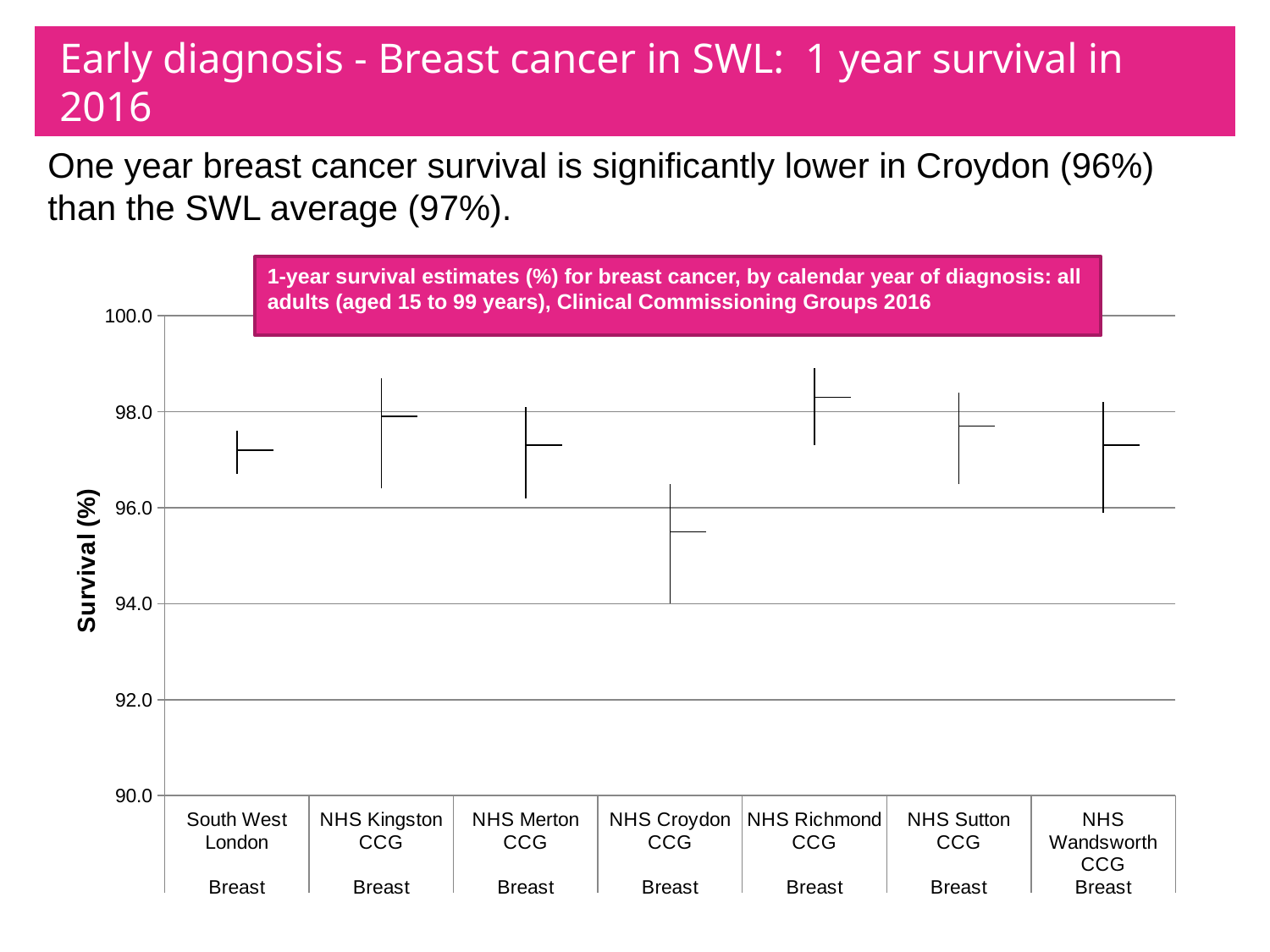
Which CCG has the lowest 1-year breast cancer survival estimate on the chart? NHS Croydon CCG Is the survival estimate for NHS Richmond CCG greater or less than 98.0? greater Is the survival estimate for NHS Merton CCG greater or less than 96.0? greater Is the survival estimate for South West London greater or less than 98.0? less Which has the higher survival estimate, NHS Sutton CCG or NHS Croydon CCG? NHS Sutton CCG What is the lowest value shown on the vertical axis of the chart? 90.0 Which has the higher survival estimate, NHS Croydon CCG or NHS Richmond CCG? NHS Richmond CCG What is the label on the vertical axis of the chart? Survival (%) How many areas (categories) are plotted on the chart? 7 Which area has the highest 1-year breast cancer survival estimate on the chart? NHS Richmond CCG